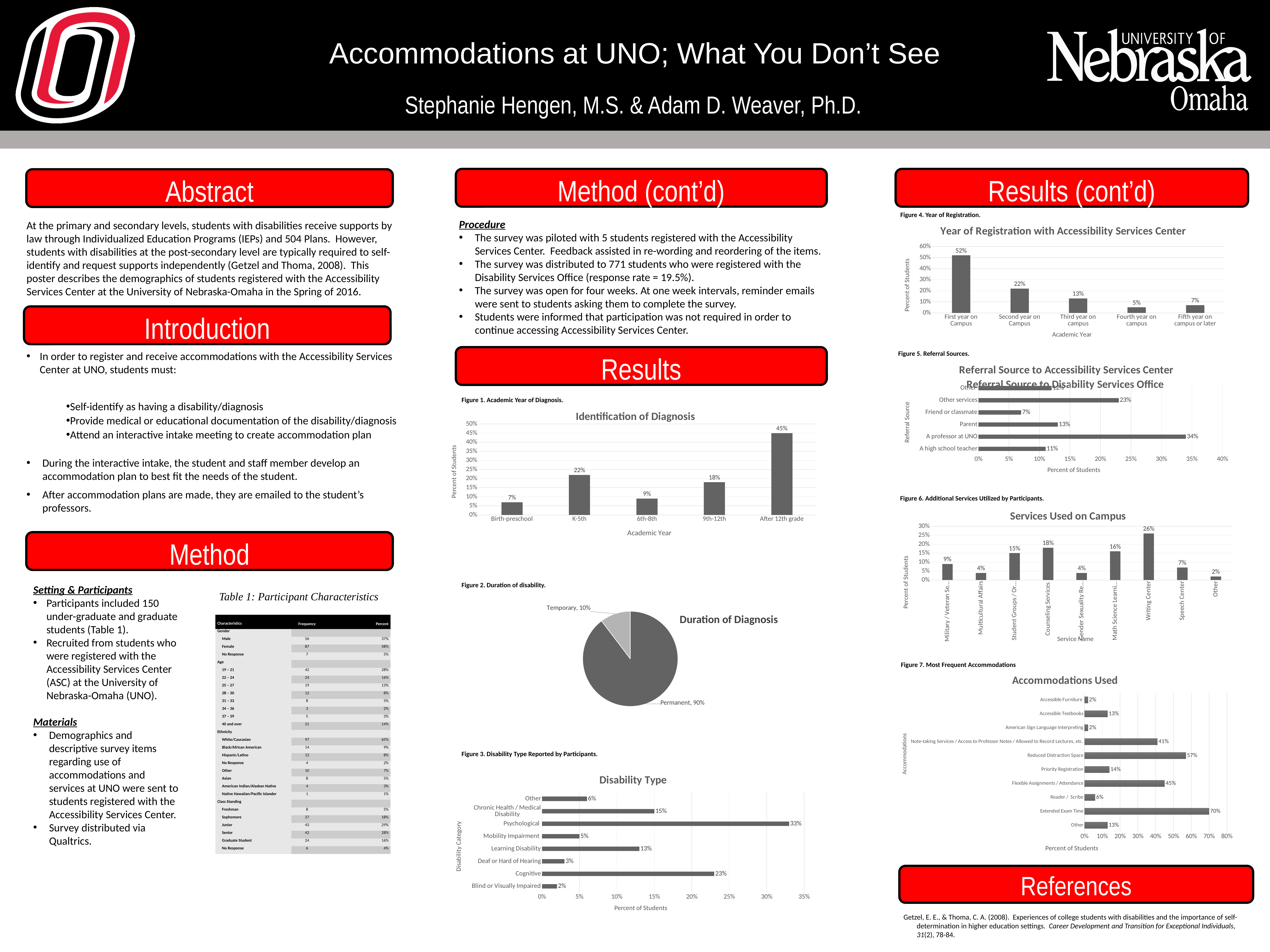
In the "Disability Type" chart, what is the value for Cognitive? 23% In the "Year of Registration with Accessibility Services Center" chart, which is larger: Fourth year on campus or Fifth year on campus or later? Fifth year on campus or later In the "Duration of Diagnosis" pie chart, what share is Permanent? 90% In the "Accommodations Used" chart, what is the value for Extended Exam Time? 70% In the "Identification of Diagnosis" chart, what is the difference between K-5th and 9th-12th? 4% In the "Disability Type" chart, which disability category has the highest percentage? Psychological In the "Identification of Diagnosis" chart, which academic year has the lowest percentage? Birth-preschool What type of chart is "Accommodations Used"? Bar chart In the "Disability Type" chart, how many disability categories are shown? 8 In the "Year of Registration with Accessibility Services Center" chart, what is the value for First year on Campus? 52% In the "Identification of Diagnosis" chart, what is the value for After 12th grade? 45% In the "Services Used on Campus" chart, which service has the highest percentage? Writing Center